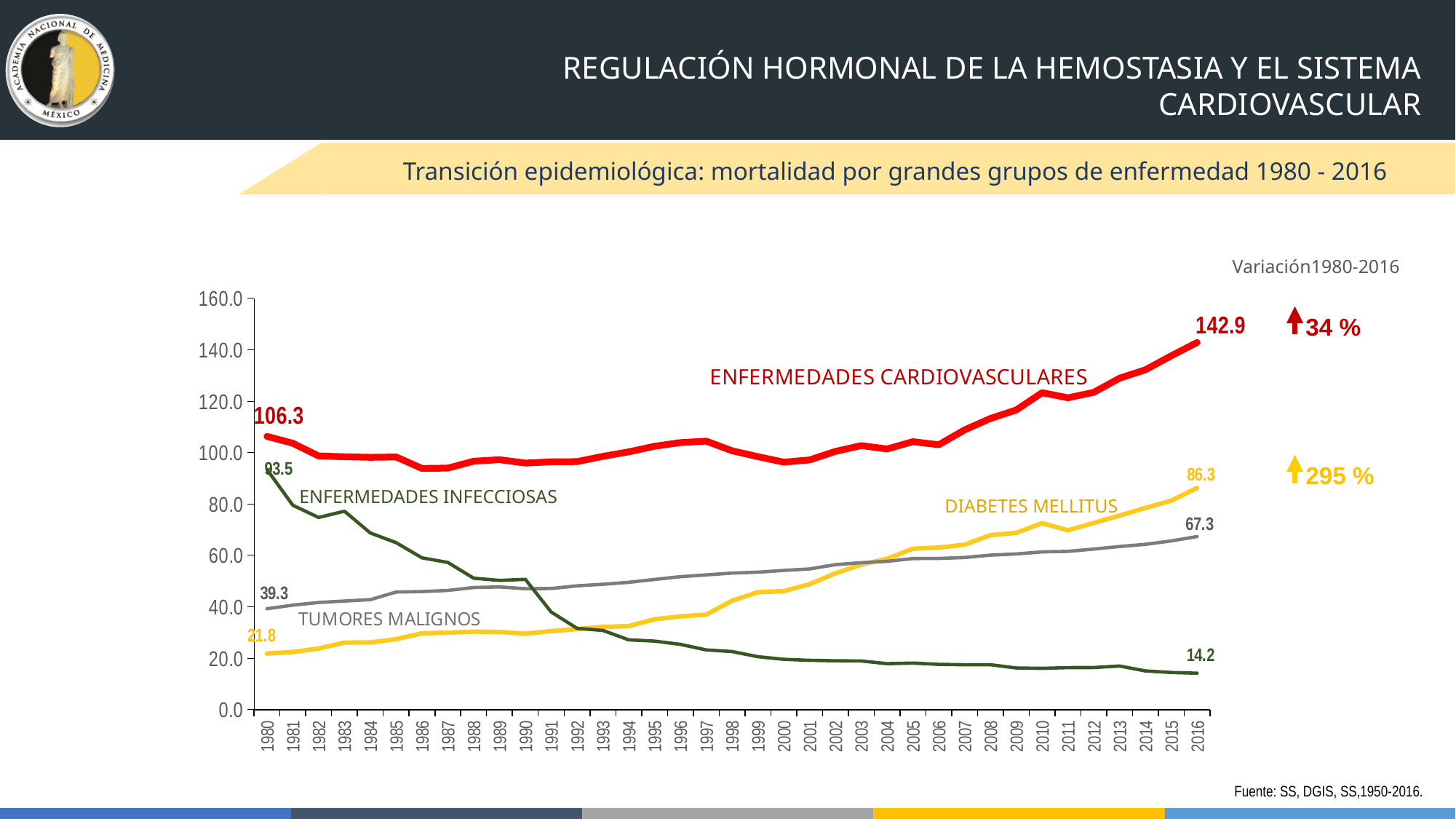
What is the value for Tumores malignos in 2016? 67.3 What kind of chart is shown on the slide? line chart What percentage variation from 1980 to 2016 is shown for Diabetes mellitus? 295 % What is the difference between the 2016 and 1980 values for Enfermedades infecciosas? 79.3 What is the value for Enfermedades cardiovasculares in 1980? 106.3 What is the value for Diabetes mellitus in 1980? 21.8 Does the value for Enfermedades infecciosas rise or fall from 1980 to 2016? fall Which is larger in 2016, the value for Diabetes mellitus or the value for Tumores malignos? Diabetes mellitus Which series has the highest value in 2016? Enfermedades cardiovasculares What is the value for Enfermedades cardiovasculares in 2016? 142.9 What is the value for Enfermedades infecciosas in 2016? 14.2 Which series has the lowest value in 1980? Diabetes mellitus